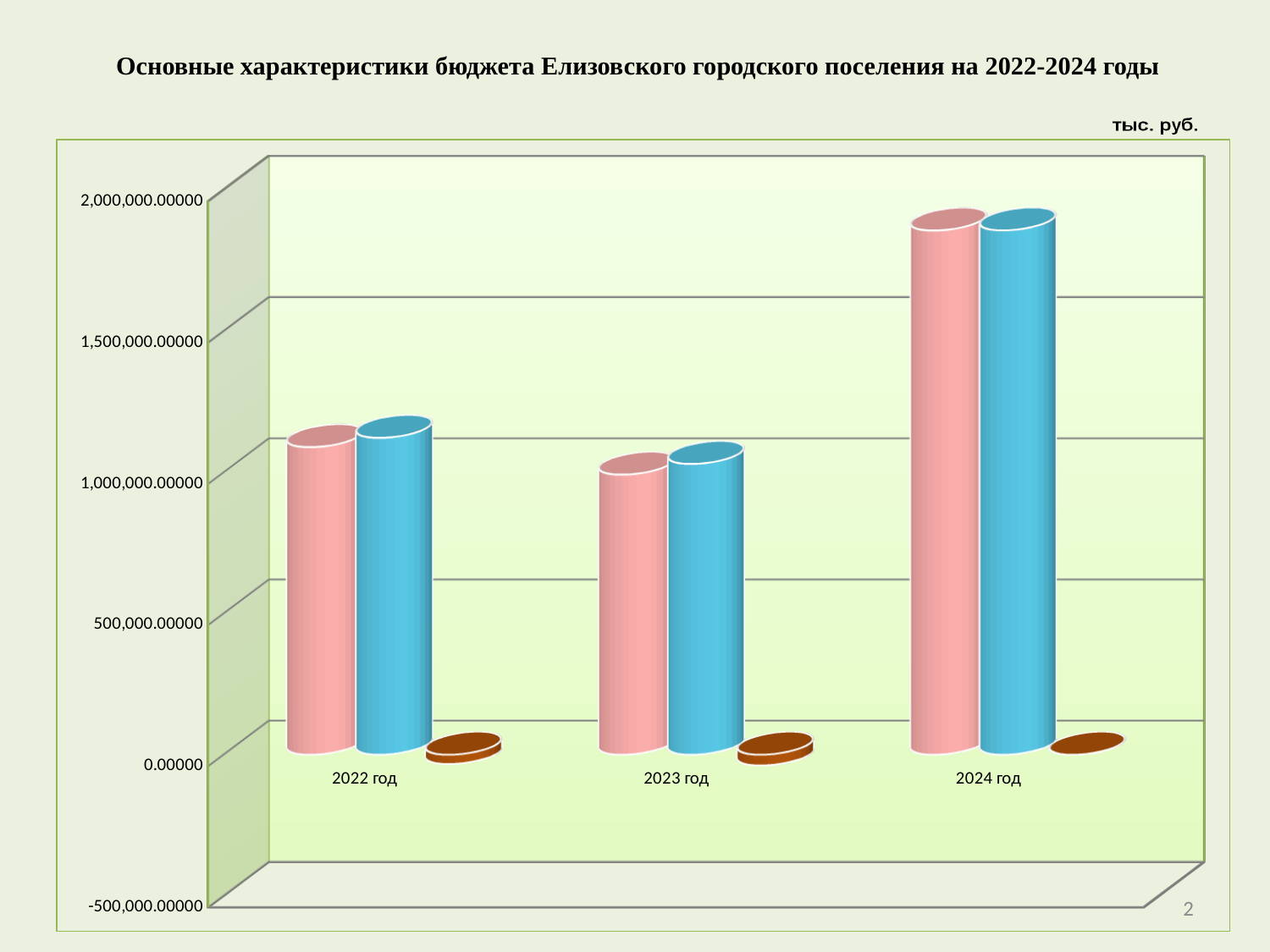
Does the blue bar rise or fall from 2023 год to 2024 год? rise Is the pink bar for 2022 год greater or less than 1,000,000.00000? greater How many year categories are shown on the x axis? 3 Is the pink bar for 2024 год greater or less than 1,500,000.00000? greater In which year is the pink bar the shortest? 2023 год Is the blue bar for 2024 год greater or less than 2,000,000.00000? less What kind of chart is shown on the slide? bar chart What unit of measurement is indicated above the chart? тыс. руб. In which year is the blue bar the tallest? 2024 год How many bars are plotted for each year? 3 Which is larger, the pink bar for 2022 год or the pink bar for 2024 год? 2024 год In which year is the pink bar the tallest? 2024 год